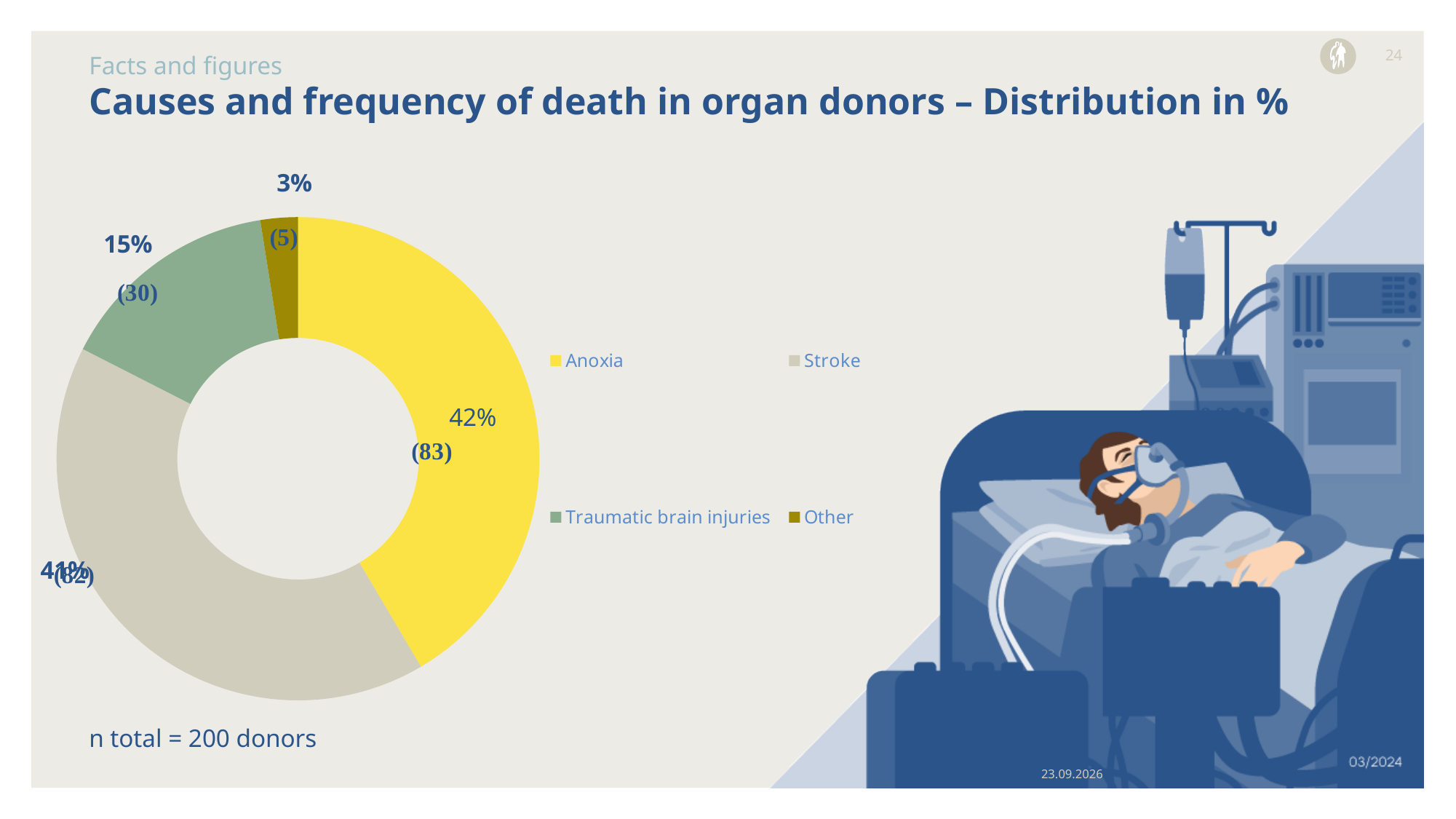
How many donors are in the Traumatic brain injuries category, according to the number in parentheses? 30 How many donors are in the Other category, according to the number in parentheses? 5 Which cause of death has the smallest share of the chart? Other Which cause of death has the largest share of the chart? Anoxia What percentage of organ donor deaths falls under Other? 3% What percentage of organ donor deaths is attributed to Traumatic brain injuries? 15% How many categories does the legend list? 4 What percentage of organ donor deaths is attributed to Anoxia? 42% How many donors are in the Anoxia category, according to the number in parentheses? 83 What is the difference in percentage points between Traumatic brain injuries and Other? 12 What kind of chart is shown on the slide? Doughnut (pie) chart What is the total number of donors stated below the chart? 200 donors